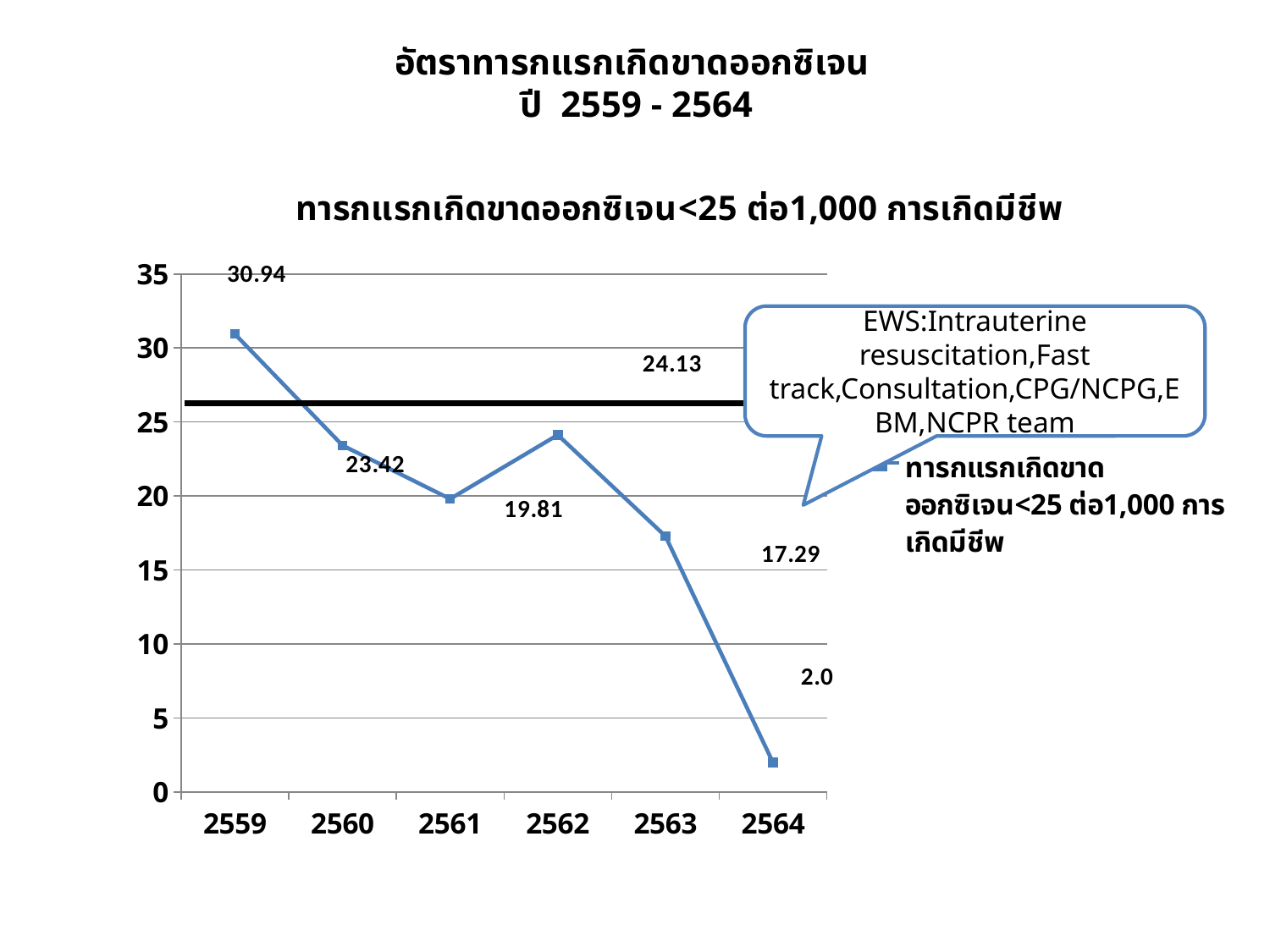
Which year has the lowest value? 2564 How many years are plotted on the x axis? 6 What is the value for 2564? 2.0 What is the difference between the values for 2559 and 2560? 7.52 Which is larger, the value for 2562 or the value for 2563? 2562 What is the value for 2559? 30.94 What is the value for 2561? 19.81 Does the value rise or fall from 2562 to 2564? fall What kind of chart is shown? line chart Which year has the highest value? 2559 Is the value for 2563 greater or less than 20? less What is the value for 2562? 24.13